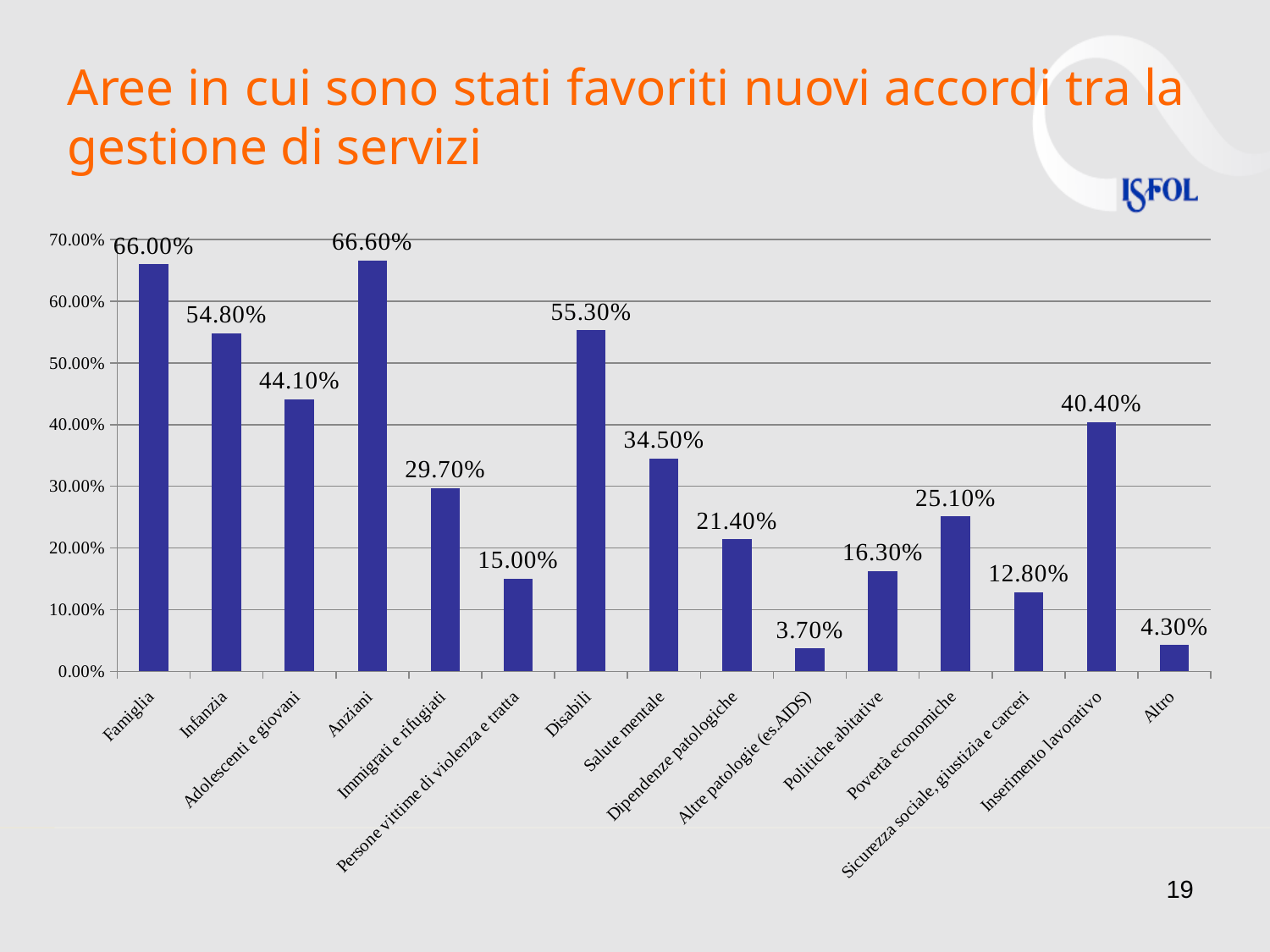
What is the difference between the values for Anziani and Famiglia? 0.60% What is the difference between the values for Salute mentale and Dipendenze patologiche? 13.10% How many categories are shown on the x axis? 15 What is the value for Disabili? 55.30% Is the value for Povertà economiche greater or less than 20.00%? greater Which category has the highest value? Anziani Which category has the lowest value? Altre patologie (es.AIDS) What kind of chart is shown on the slide? Bar chart What is the value for Famiglia? 66.00% What is the value for Inserimento lavorativo? 40.40% Which is larger, the value for Infanzia or the value for Adolescenti e giovani? Infanzia What is the value for Persone vittime di violenza e tratta? 15.00%